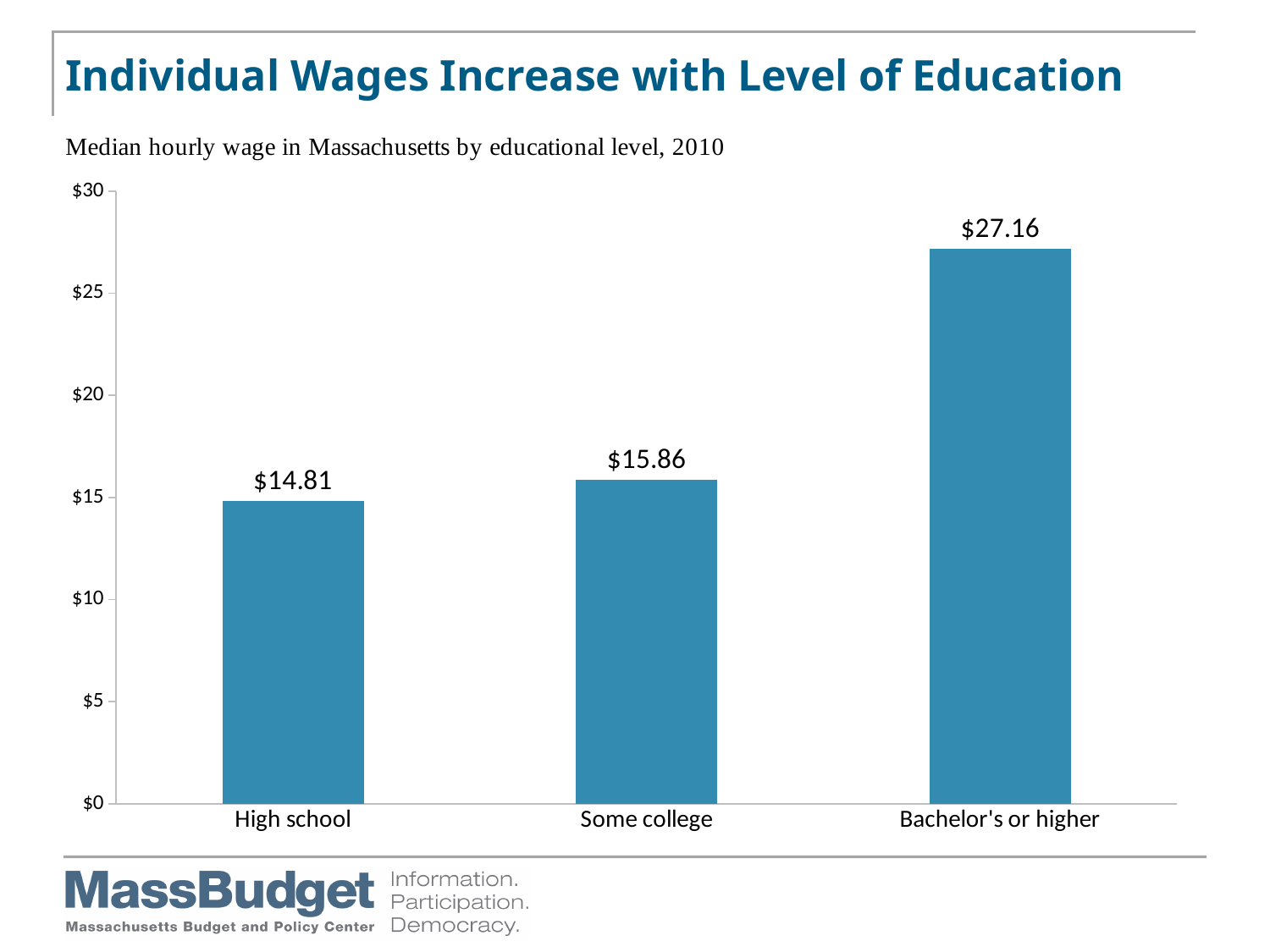
What is the median hourly wage for Some college? $15.86 Which educational level has the lowest median hourly wage? High school Which is larger, the median hourly wage for Some college or for High school? Some college Do the values rise or fall from High school to Bachelor's or higher? Rise What is the difference in median hourly wage between Some college and High school? $1.05 What is the median hourly wage for Bachelor's or higher? $27.16 What kind of chart is shown on the slide? Bar chart Is the value for Bachelor's or higher greater or less than $25? greater What is the median hourly wage for High school? $14.81 Which educational level has the highest median hourly wage? Bachelor's or higher How many educational levels are shown in the chart? 3 What is the difference in median hourly wage between Bachelor's or higher and High school? $12.35